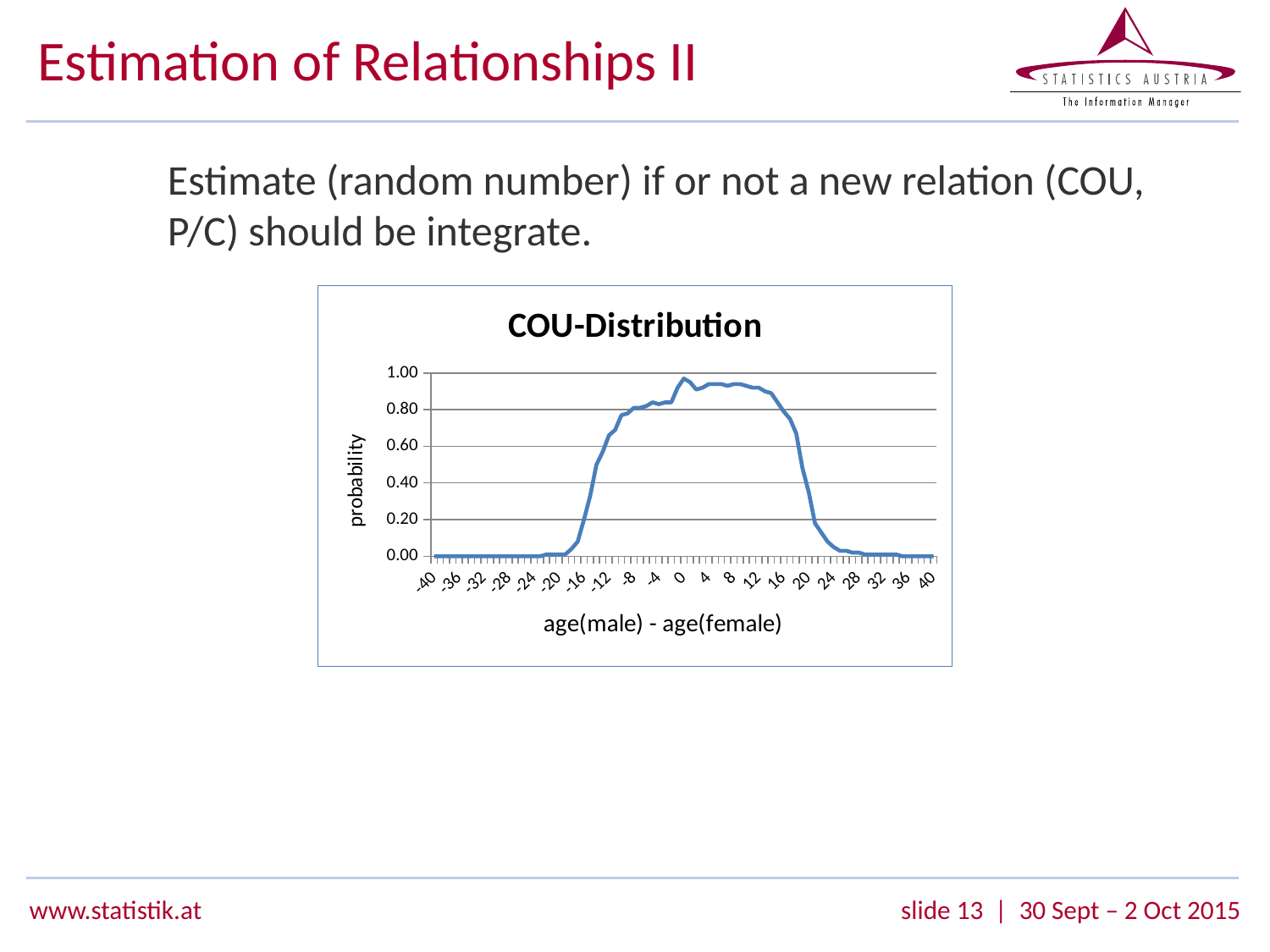
Is the probability at age(male) - age(female) = 28 greater or less than 0.20? less Is the probability at age(male) - age(female) = 40 greater or less than 0.20? less Does the probability rise or fall as age(male) - age(female) goes from -20 to 0? rise What is the label of the vertical axis of the chart? probability Is the probability at age(male) - age(female) = -40 greater or less than 0.20? less What kind of chart is shown on the slide? line chart What is the title of the chart? COU-Distribution Which has the larger probability: age(male) - age(female) = 4 or age(male) - age(female) = 24? 4 Does the probability rise or fall as age(male) - age(female) goes from 16 to 24? fall